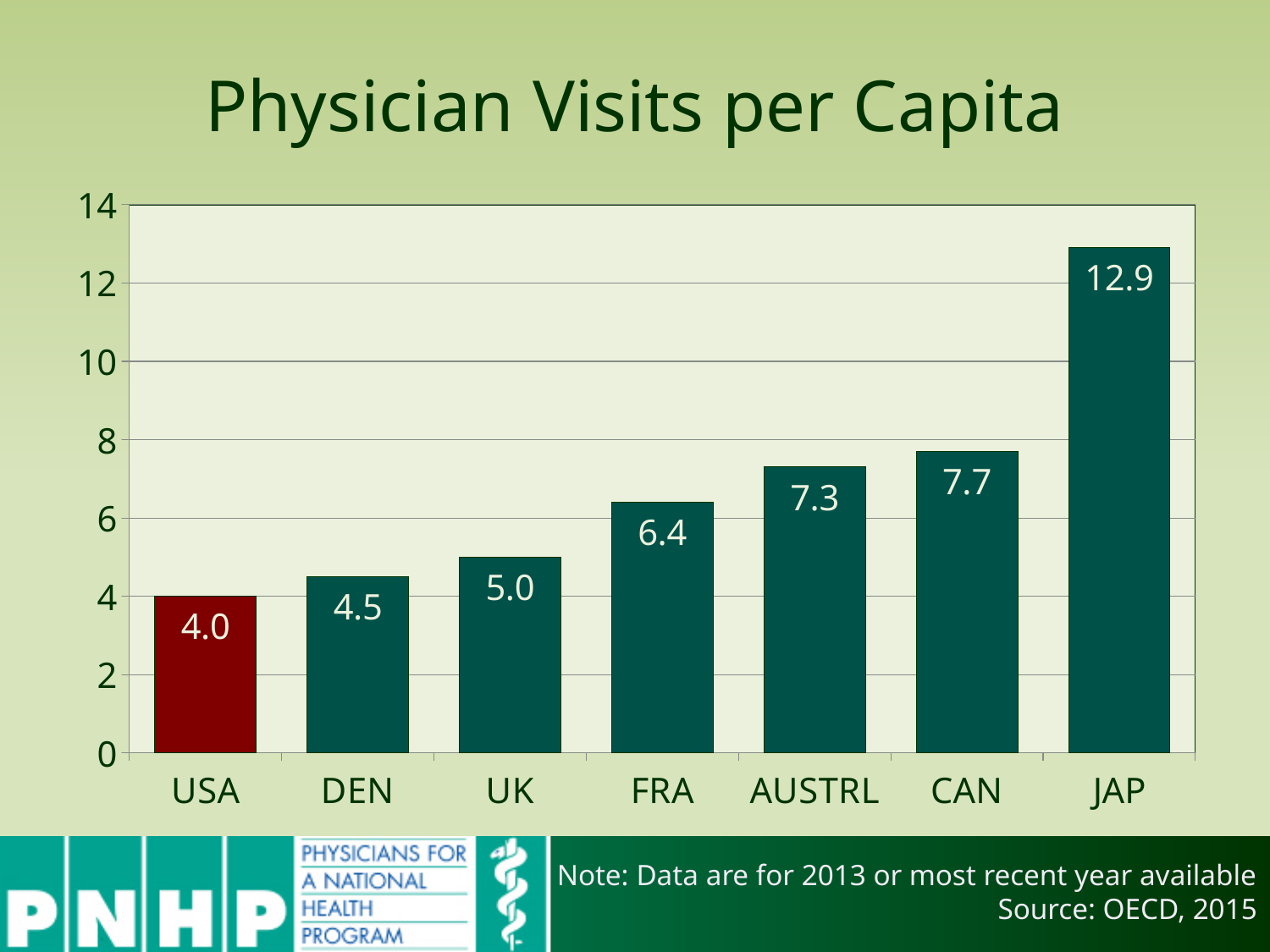
What kind of chart is this? bar chart What is the difference between the values for CAN and AUSTRL? 0.4 How many countries are shown on the chart? 7 Which country has the lowest physician visits per capita? USA What is the value for USA? 4.0 What is the value for FRA? 6.4 Which is larger, the value for DEN or the value for UK? UK Which bar is coloured differently from the others? USA Which country has the highest physician visits per capita? JAP Do the values rise or fall from left to right along the x axis? rise What is the difference between the values for JAP and USA? 8.9 What is the value for JAP? 12.9